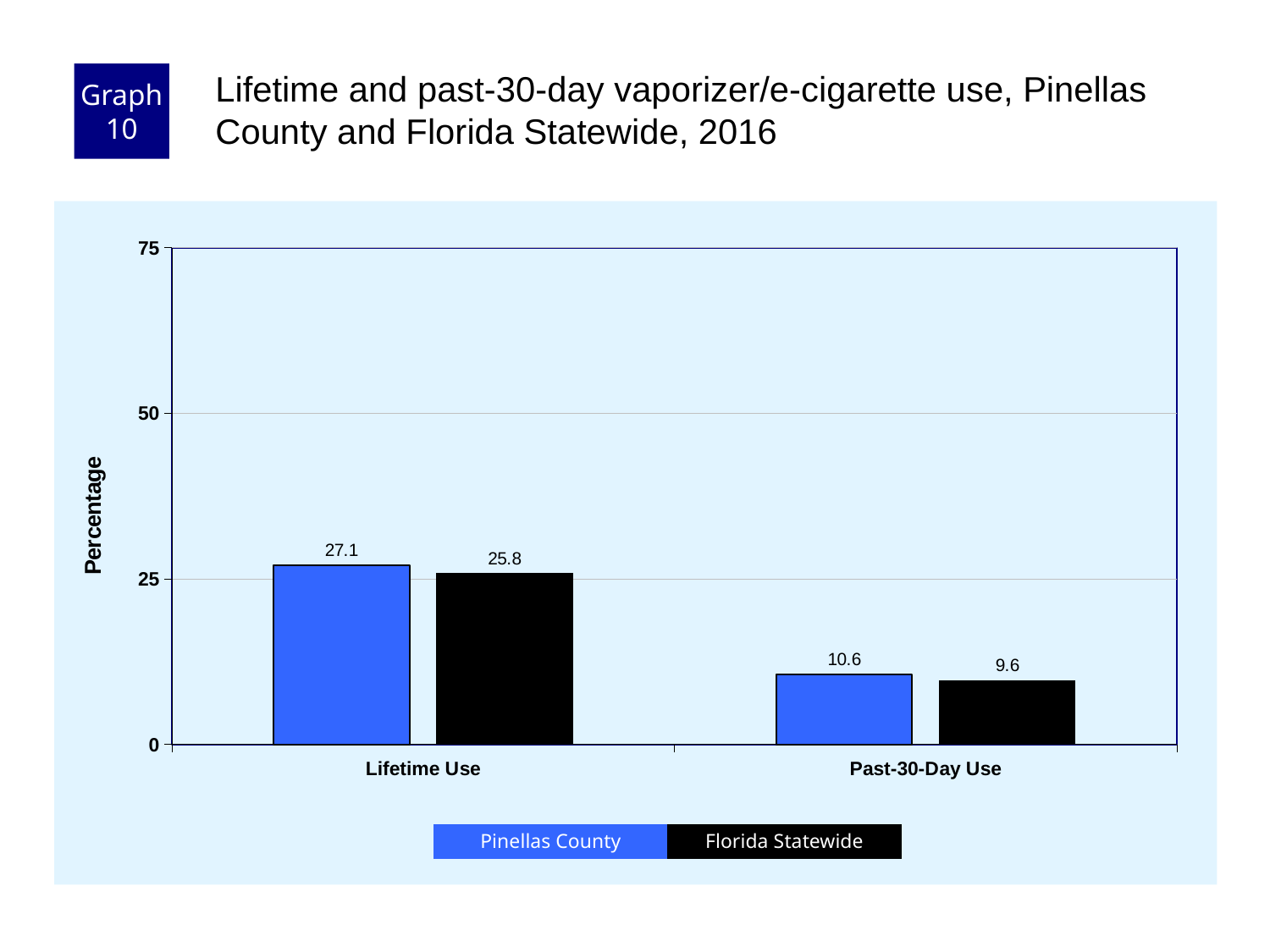
How many categories are shown on the x axis? 2 Is the value for Pinellas County for Lifetime Use greater or less than 25? greater What is the value for Florida Statewide for Lifetime Use? 25.8 Which is larger for Past-30-Day Use, Pinellas County or Florida Statewide? Pinellas County Which category has the highest value for Pinellas County? Lifetime Use What is the difference between Pinellas County and Florida Statewide for Lifetime Use? 1.3 What kind of chart is shown on the slide? Bar chart What is the value for Pinellas County for Lifetime Use? 27.1 Which category has the lowest value for Florida Statewide? Past-30-Day Use What is the difference between Pinellas County and Florida Statewide for Past-30-Day Use? 1.0 How many series does the legend list? 2 What is the value for Florida Statewide for Past-30-Day Use? 9.6